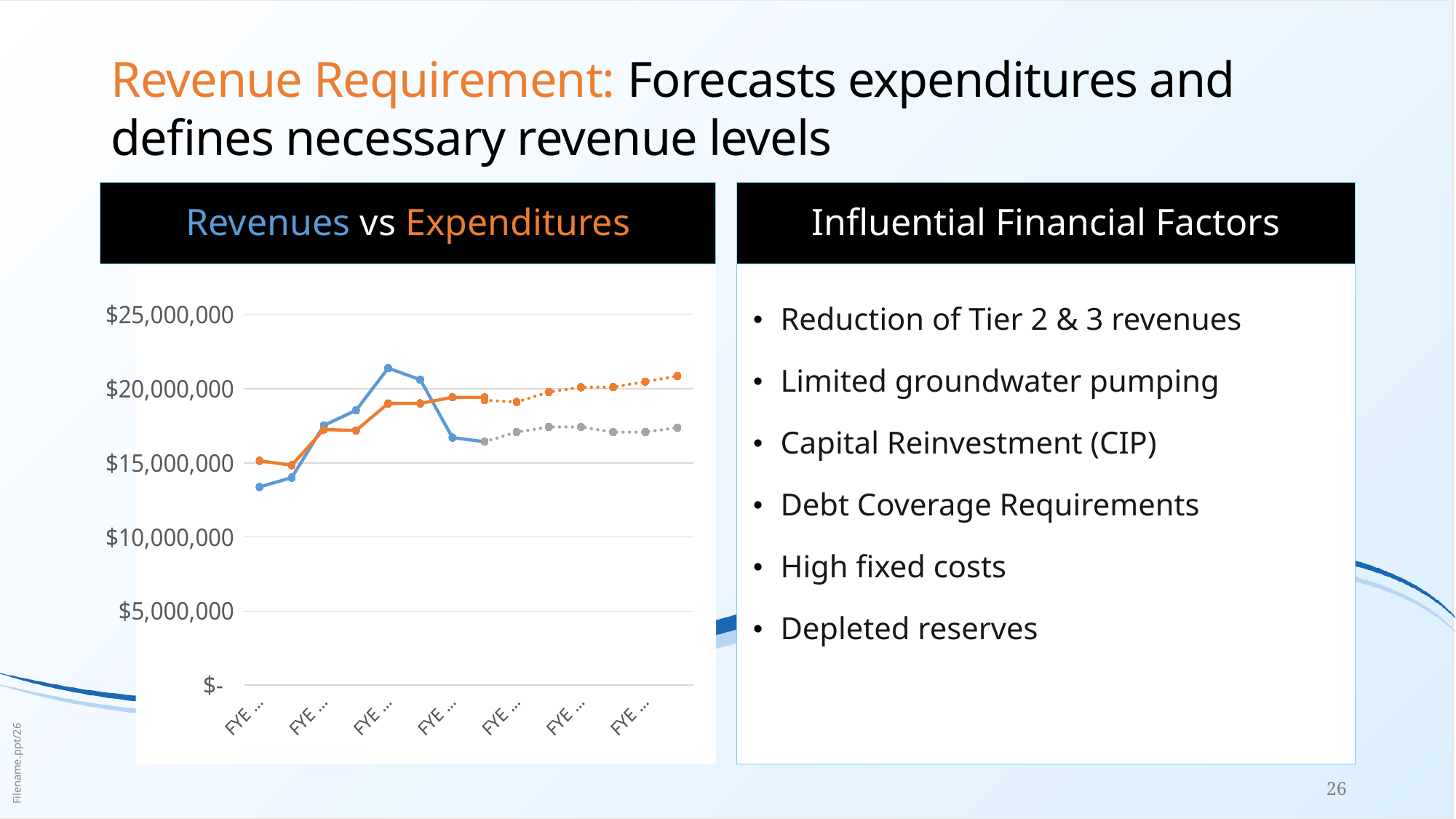
In the Revenues vs Expenditures chart, is the last point of the orange dotted line greater or less than $20,000,000? greater What is the title of the chart on the left of the slide? Revenues vs Expenditures In the Revenues vs Expenditures chart, at the first point on the left, which line is higher: the blue line or the orange line? the orange line In the Revenues vs Expenditures chart, what is the highest value labelled on the vertical axis? $25,000,000 In the Revenues vs Expenditures chart, is every point of the blue line greater or less than $10,000,000? greater In the Revenues vs Expenditures chart, does the orange line generally rise or fall from left to right? rise In the Revenues vs Expenditures chart, at the right-hand end, which line is higher: the orange dotted line or the grey dotted line? the orange dotted line What kind of chart is shown under the heading "Revenues vs Expenditures"? line chart In the Revenues vs Expenditures chart, is the peak of the blue line greater or less than $20,000,000? greater